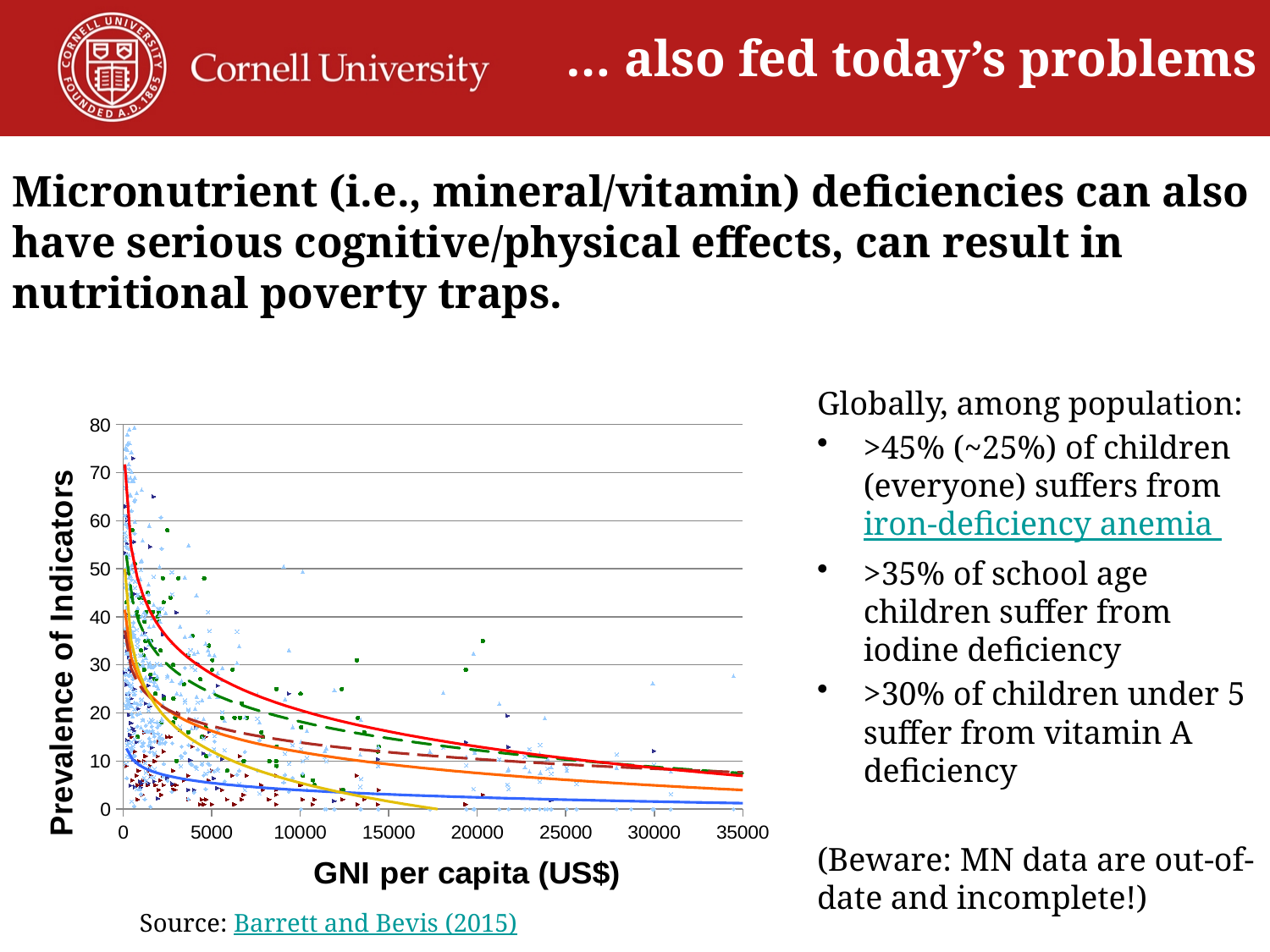
Is the value of the blue curve at a GNI per capita of 35000 greater or less than 10? less Is the value of the red curve at a GNI per capita of 35000 greater or less than 10? less Does the yellow curve reach a prevalence of 0 before or after a GNI per capita of 20000? before What is the highest value shown on the vertical axis of the chart? 80 Do the fitted curves rise or fall as GNI per capita increases? fall What is the highest value shown on the horizontal axis of the chart? 35000 How many fitted curves are drawn on the chart? 6 What is the label of the horizontal axis of the chart? GNI per capita (US$) What kind of chart is shown on the slide? scatter plot Which curve starts at the highest prevalence near a GNI per capita of 0, the red curve or the blue curve? the red curve What is the label of the vertical axis of the chart? Prevalence of Indicators